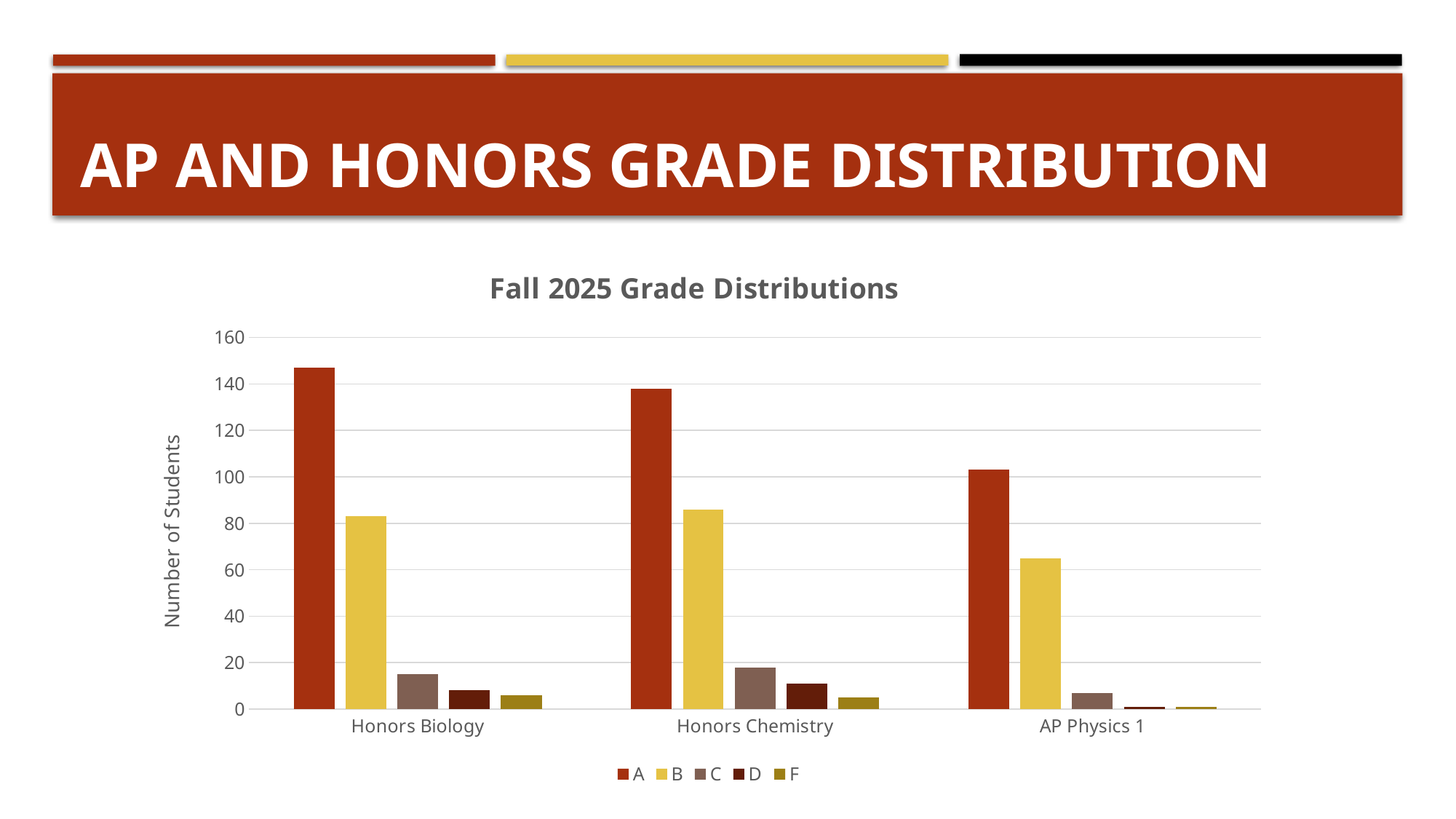
How many courses are shown along the x axis of the chart? 3 Which course has more students with a B: Honors Biology or AP Physics 1? Honors Biology How many grade series does the legend list? 5 Which course has the lowest number of students with an A? AP Physics 1 Is the number of A grades for Honors Biology greater or less than 140? greater Which course has the highest number of students with an A? Honors Biology What is the label on the vertical axis of the chart? Number of Students Do the A grade counts rise or fall moving from Honors Biology to AP Physics 1 along the x axis? fall Is the number of A grades for AP Physics 1 greater or less than 100? greater What is the title of the chart? Fall 2025 Grade Distributions What type of chart is shown on the slide? Bar chart Is the number of B grades for AP Physics 1 greater or less than 60? greater